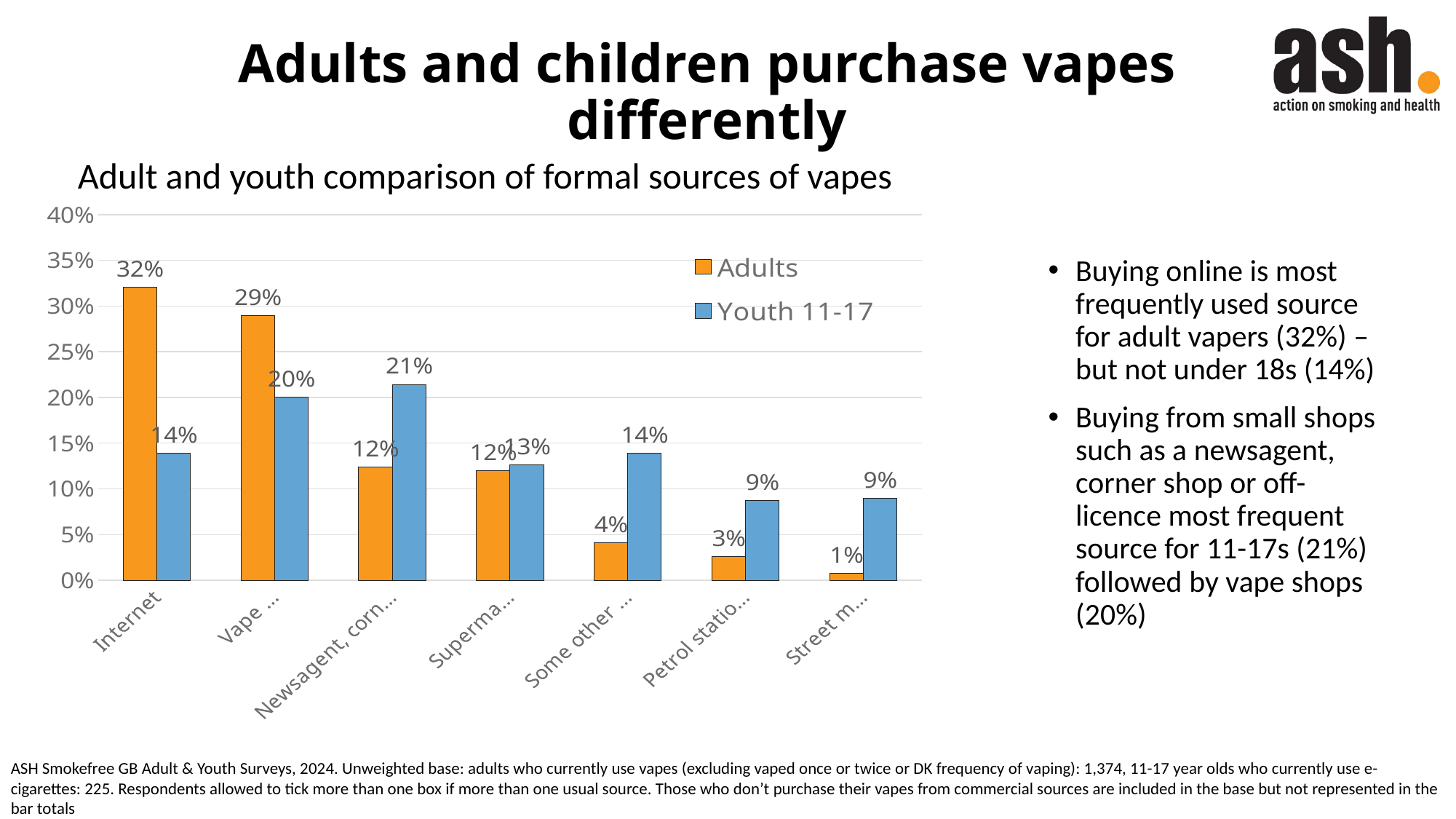
What is the title of the chart? Adult and youth comparison of formal sources of vapes How many categories are shown on the x axis? 7 What is the Youth 11-17 value for Internet? 14% How many series does the legend list? 2 What is the highest value plotted for the Youth 11-17 series? 21% What kind of chart is shown? Bar chart What is the lowest value plotted for the Adults series? 1% Which category has the highest Adults value? Internet What is the Adults value for Internet? 32% Do the Adults values generally rise or fall from left to right along the x axis? Fall What is the difference between the Adults and Youth 11-17 values for Internet? 18% For Internet, which series has the larger value, Adults or Youth 11-17? Adults